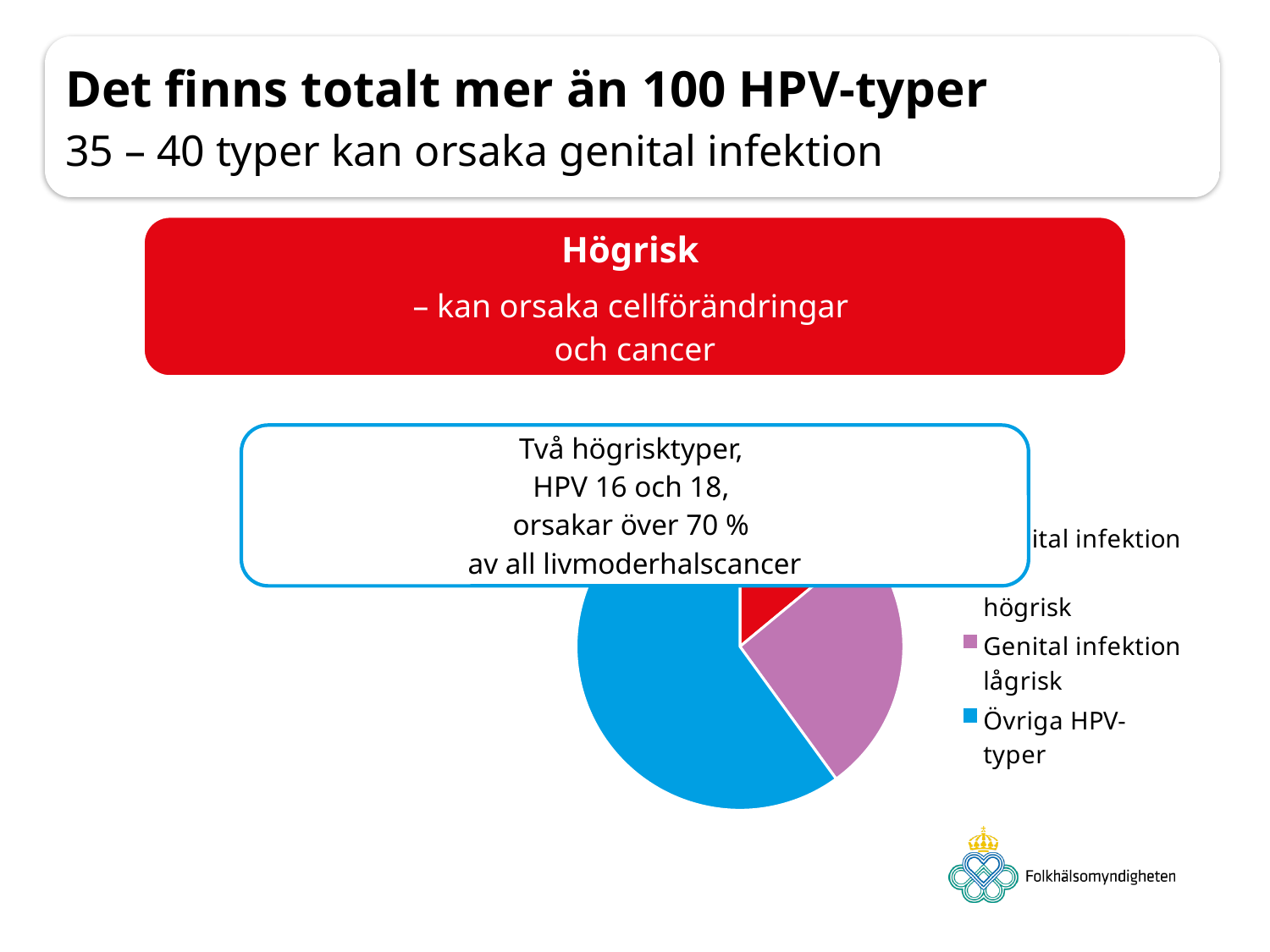
What colour is the slice for Genital infektion lågrisk in the pie chart? purple How many slices does the pie chart have? 3 Which is larger in the pie chart: Övriga HPV-typer or Genital infektion lågrisk? Övriga HPV-typer How many entries does the legend of the pie chart list? 3 What colour is the slice for Övriga HPV-typer in the pie chart? blue Which is larger in the pie chart: Genital infektion lågrisk or the red högrisk slice? Genital infektion lågrisk Does the slice for Övriga HPV-typer cover more or less than half of the pie? more Which category has the largest slice in the pie chart? Övriga HPV-typer What kind of chart is shown on the slide? pie chart